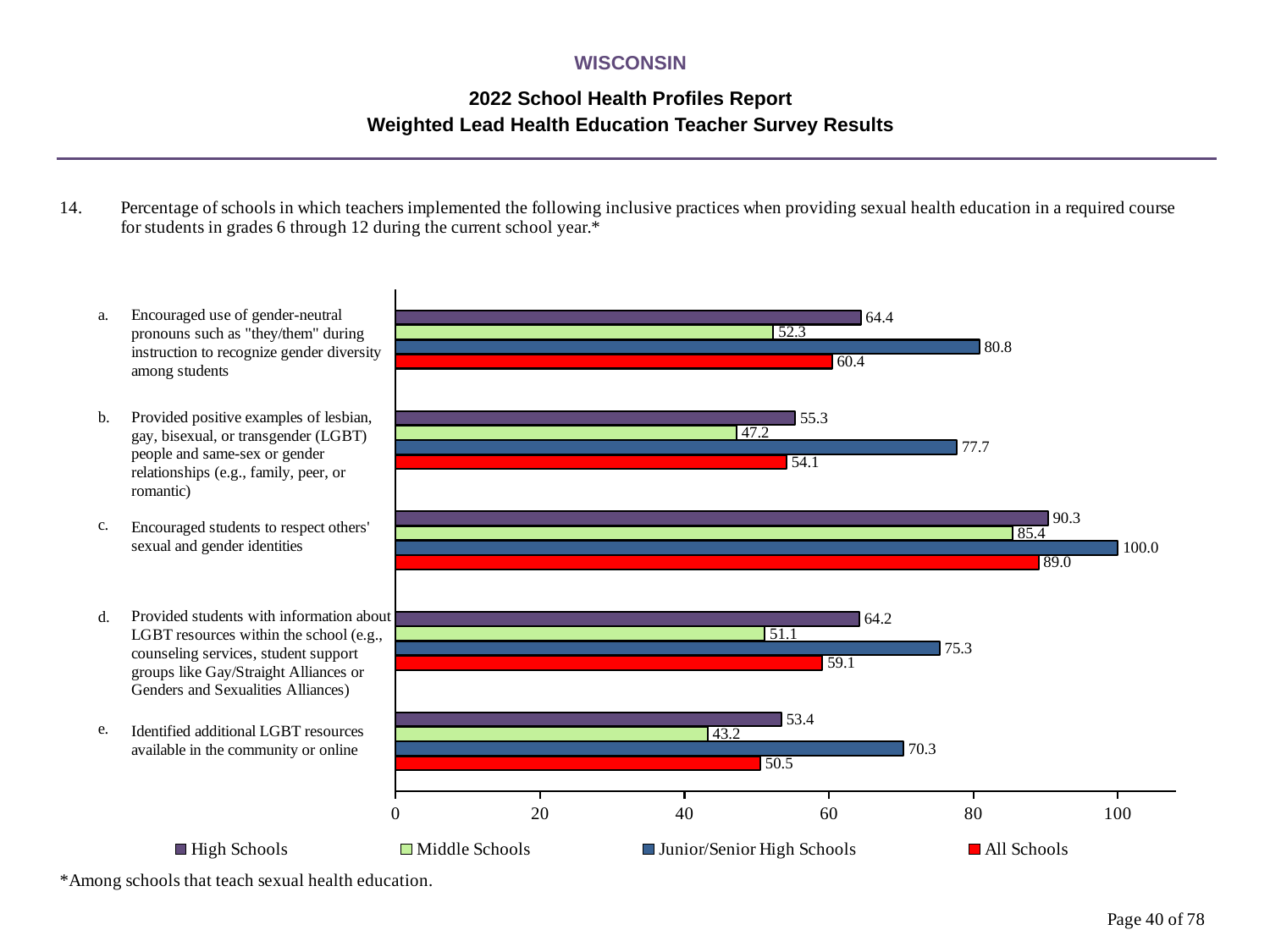
What kind of chart is shown on the slide? Bar chart For item d, "Provided students with information about LGBT resources within the school", which is larger: the High Schools value or the All Schools value? High Schools What is the value for Junior/Senior High Schools for item c, "Encouraged students to respect others' sexual and gender identities"? 100.0 How many inclusive practices (categories) are shown in the chart? 5 What is the value for Middle Schools for item e, "Identified additional LGBT resources available in the community or online"? 43.2 Which series is shown in red in the legend? All Schools Which item has the highest value for High Schools? c. Encouraged students to respect others' sexual and gender identities Is the Middle Schools value for item c, "Encouraged students to respect others' sexual and gender identities", greater or less than 80? greater What is the difference between the Junior/Senior High Schools value and the Middle Schools value for item b, "Provided positive examples of LGBT people and same-sex or gender relationships"? 30.5 How many series does the legend list? 4 Which item has the lowest value for All Schools? e. Identified additional LGBT resources available in the community or online What is the All Schools value for item a, "Encouraged use of gender-neutral pronouns such as 'they/them' during instruction"? 60.4